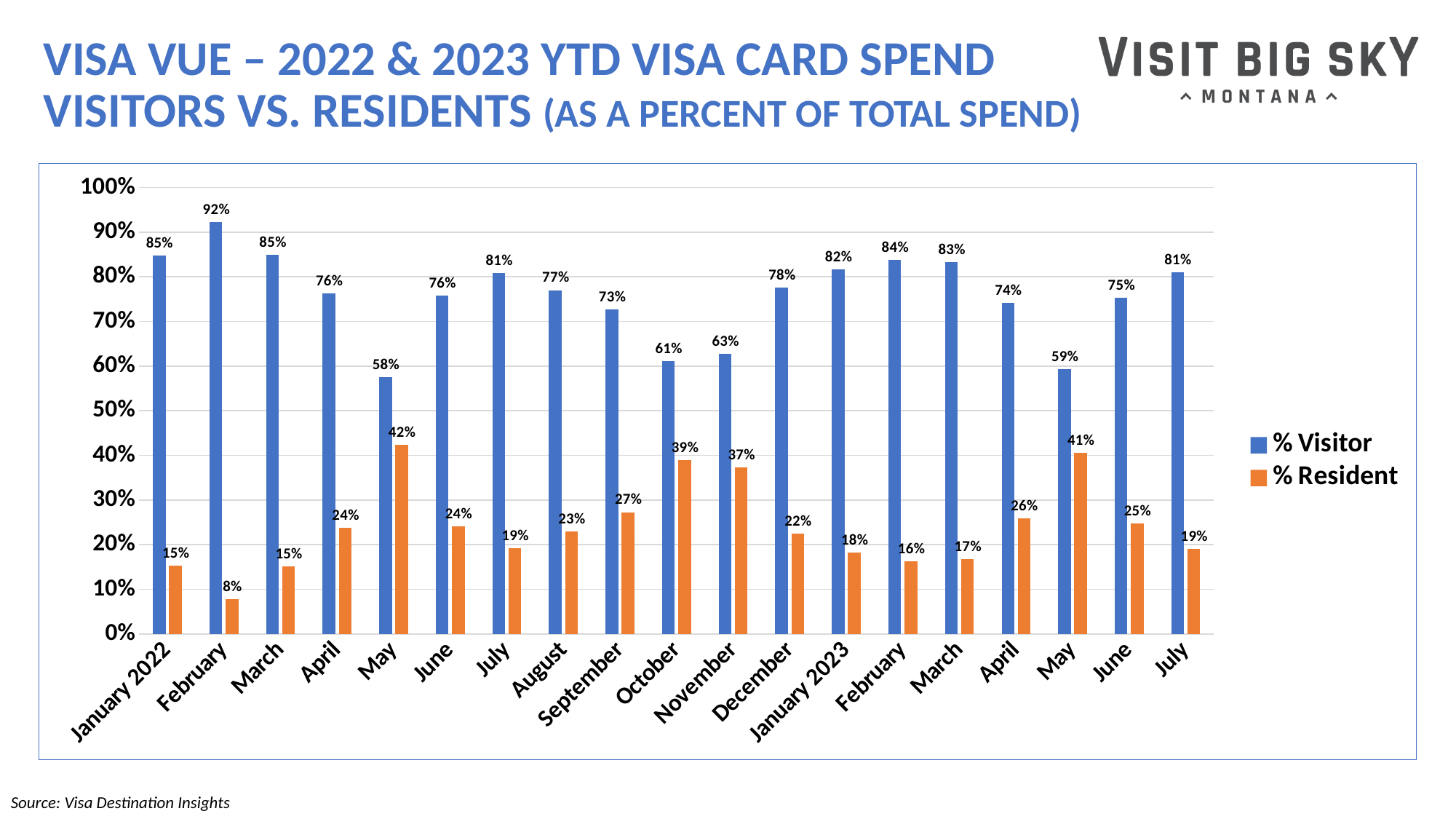
Which month has the highest % Resident value? May 2022 Which is larger, the % Visitor value for July 2022 or the % Visitor value for July 2023? They are equal (81%) What is the % Visitor value for October 2022? 61% What kind of chart is shown on the slide? Bar chart What is the % Visitor value for February 2022? 92% What is the % Resident value for January 2023? 18% How many months are shown on the x axis? 19 How many series does the legend list? 2 Which month has the lowest % Resident value? February 2022 Which month has the highest % Visitor value? February 2022 What is the difference between the % Visitor and % Resident values for May 2022? 16 percentage points What is the % Resident value for May 2023? 41%